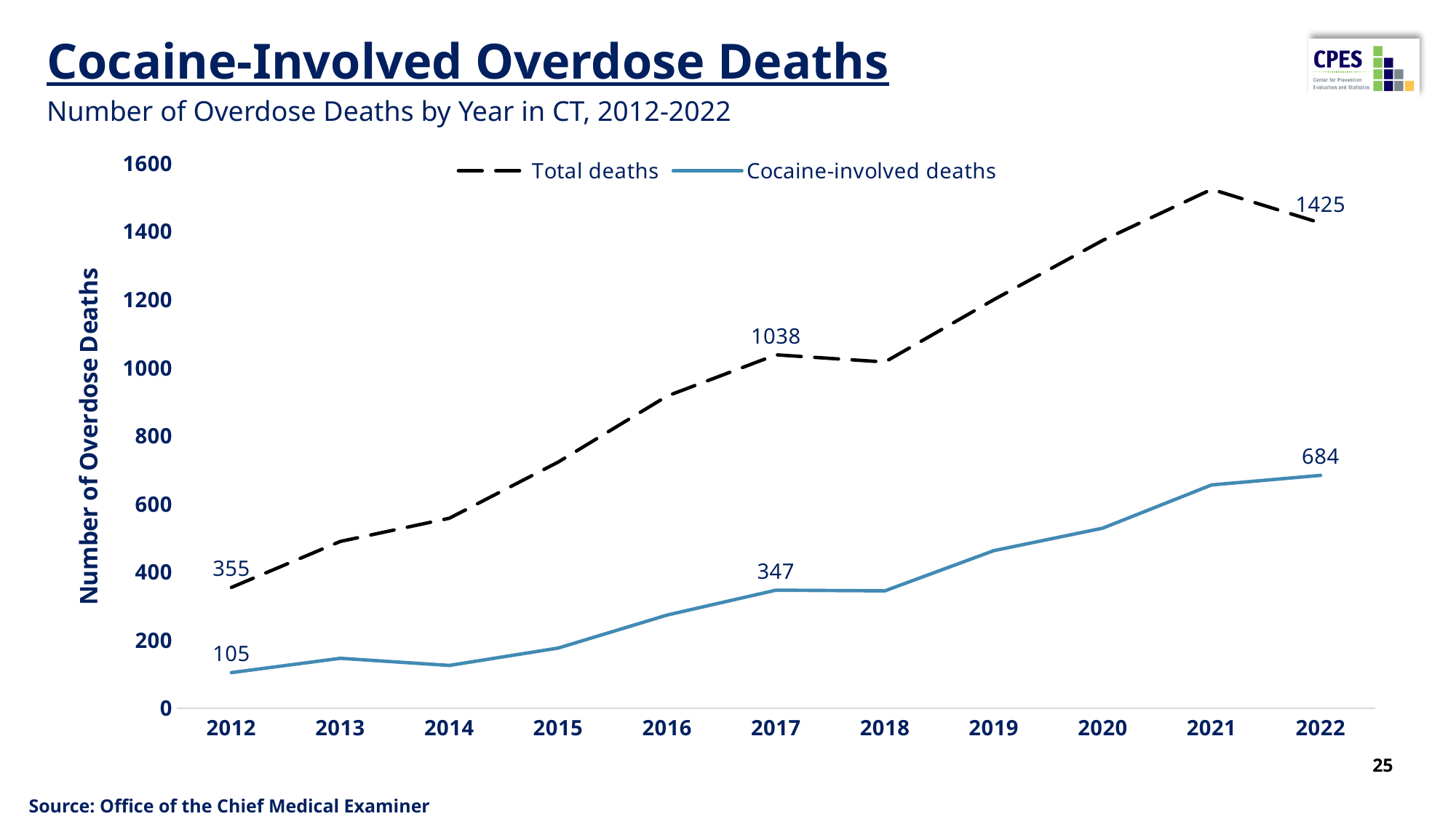
What was the number of total deaths in 2012? 355 Which year has the highest number of total deaths? 2021 How many series does the legend list? 2 How many more total deaths were there in 2022 than in 2012? 1070 What was the number of total deaths in 2017? 1038 What is the difference between total deaths and cocaine-involved deaths in 2017? 691 What was the number of cocaine-involved deaths in 2012? 105 What was the number of cocaine-involved deaths in 2022? 684 Which year has the lowest number of cocaine-involved deaths? 2012 Is the number of cocaine-involved deaths in 2015 greater or less than 200? less What kind of chart is shown on the slide? Line chart